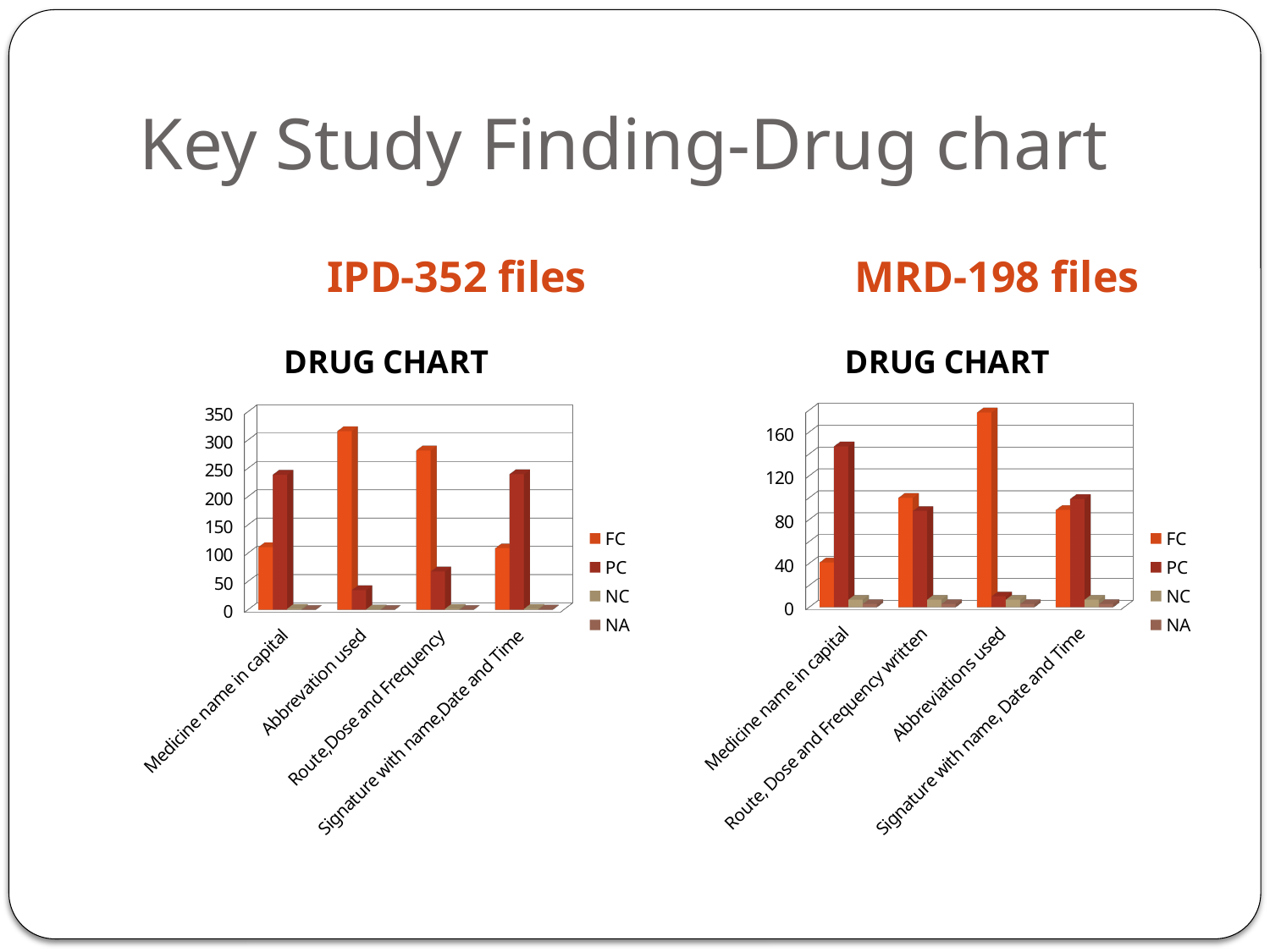
On the left chart (IPD-352 files), for Medicine name in capital, which is larger: FC or PC? PC On the left chart (IPD-352 files), which category has the highest FC value? Abbrevation used On the right chart (MRD-198 files), for Abbreviations used, which is larger: FC or PC? FC On the right chart (MRD-198 files), is the PC value for Medicine name in capital greater or less than 120? greater On the left chart (IPD-352 files), is the FC value for Abbrevation used greater or less than 300? greater On the left chart (IPD-352 files), how many series does the legend list? 4 On the left chart (IPD-352 files), how many categories are shown on the x axis? 4 On the right chart (MRD-198 files), which category has the highest FC value? Abbreviations used On the left chart (IPD-352 files), is the PC value for Abbrevation used greater or less than 50? less On the right chart (MRD-198 files), what are the legend entries? FC, PC, NC, NA On the left chart (IPD-352 files), what kind of chart is shown? bar chart